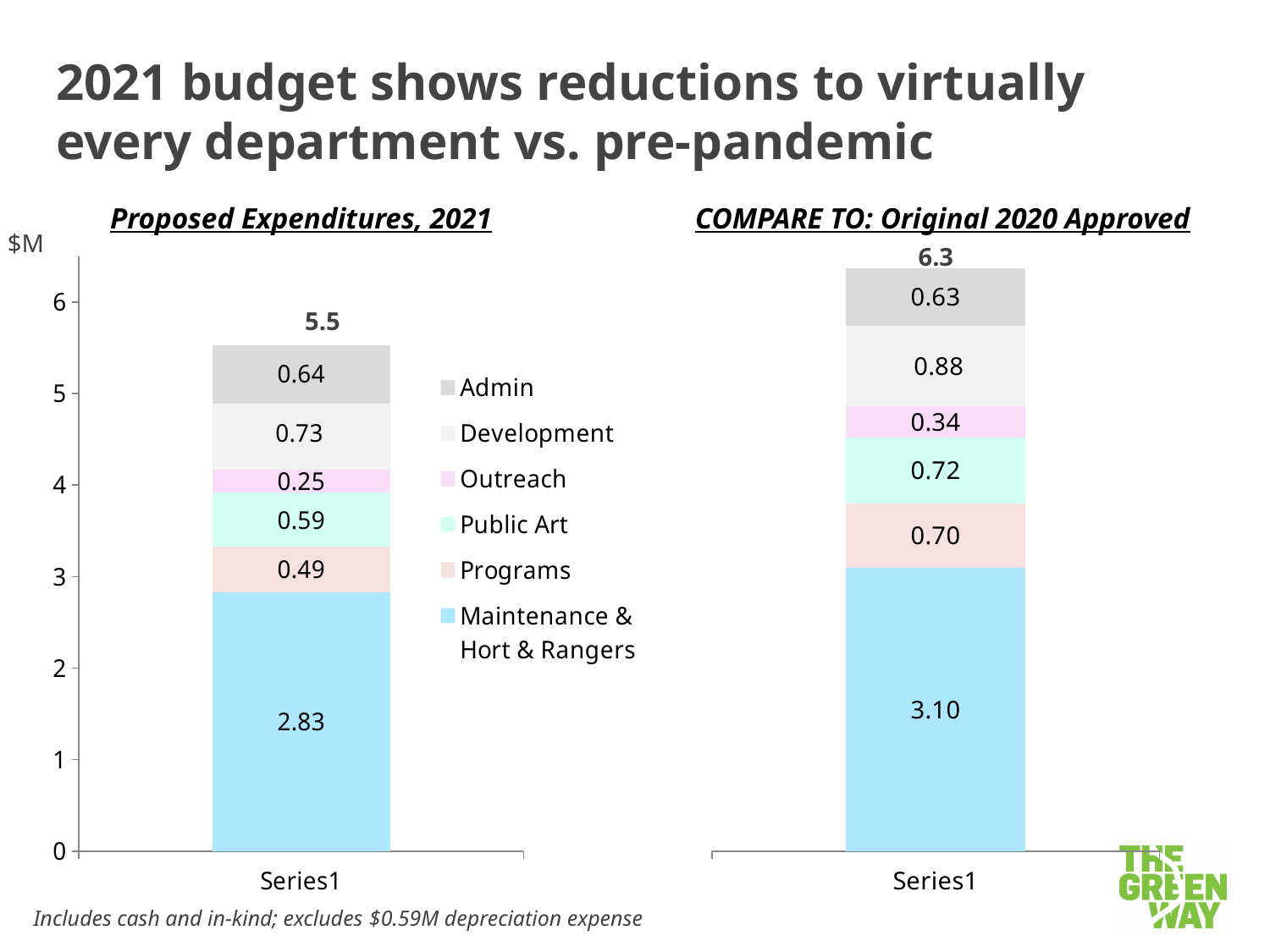
In the 'COMPARE TO: Original 2020 Approved' chart, what is the value of the Development segment? 0.88 In the 'Proposed Expenditures, 2021' chart, what is the value of the Outreach segment? 0.25 In the 'Proposed Expenditures, 2021' chart, what is the value of the Maintenance & Hort & Rangers segment? 2.83 What kind of chart is the 'Proposed Expenditures, 2021' chart? Stacked bar chart In the 'Proposed Expenditures, 2021' chart, which segment is the largest? Maintenance & Hort & Rangers In the 'Proposed Expenditures, 2021' chart, which segment is the smallest? Outreach How many series does the legend list? 6 What is the total of the stacked bar in the 'COMPARE TO: Original 2020 Approved' chart? 6.3 In the 'COMPARE TO: Original 2020 Approved' chart, what is the value of the Programs segment? 0.70 What is the difference between the Public Art value in the 'COMPARE TO: Original 2020 Approved' chart and the Public Art value in the 'Proposed Expenditures, 2021' chart? 0.13 Is the Admin value larger in the 'Proposed Expenditures, 2021' chart or in the 'COMPARE TO: Original 2020 Approved' chart? Proposed Expenditures, 2021 What is the total of the stacked bar in the 'Proposed Expenditures, 2021' chart? 5.5